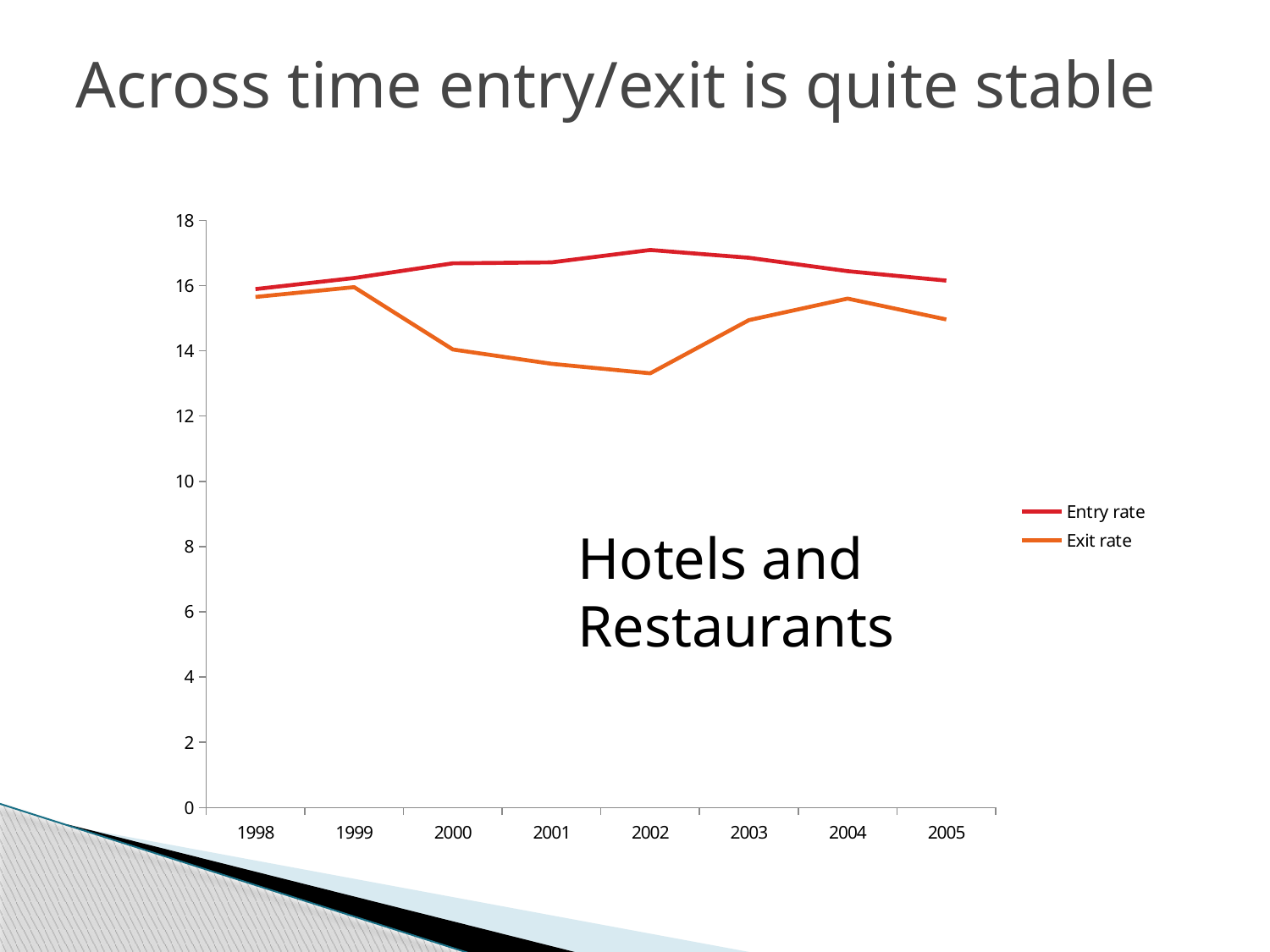
Does the Exit rate rise or fall from 2002 to 2004? rise In 2002, which is larger, the Entry rate or the Exit rate? Entry rate Is the Exit rate for 2004 greater or less than 16? less In which year is the Exit rate highest? 1999 How many series does the legend list? 2 Is the Exit rate for 2002 greater or less than 14? less In which year is the Exit rate lowest? 2002 What sector label is printed inside the chart area? Hotels and Restaurants Is the Entry rate for 2002 greater or less than 16? greater What kind of chart is shown on the slide? line chart Which series is drawn in orange? Exit rate How many years are plotted along the x axis? 8